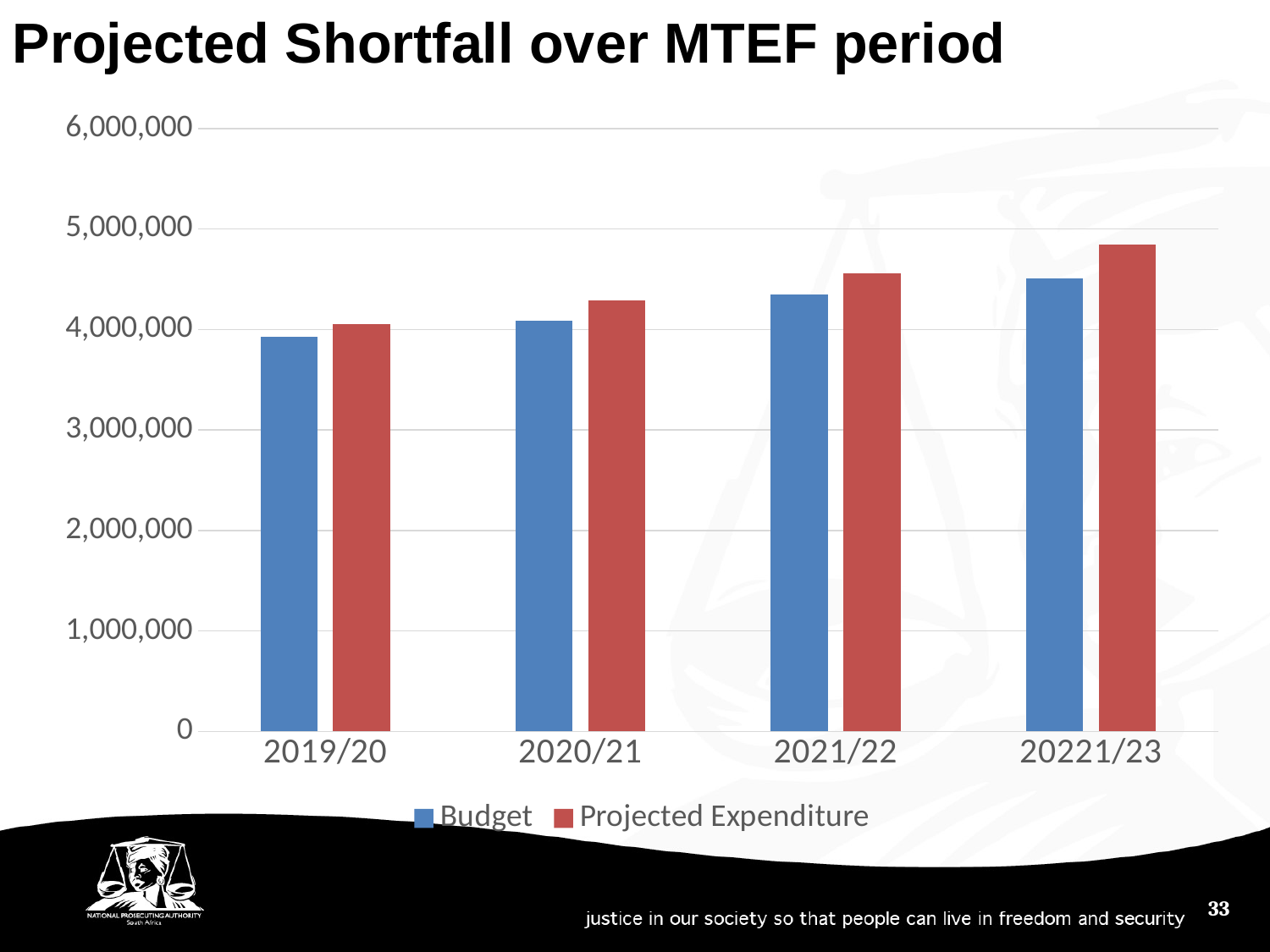
How many series does the legend list? 2 Is the Projected Expenditure for 2020/21 greater or less than 4,000,000? greater Do the Budget values rise or fall from 2019/20 to 20221/23? rise Is the Budget for 2021/22 greater or less than 4,000,000? greater Is the Budget for 2019/20 greater or less than 3,000,000? greater Which year has the highest Projected Expenditure? 20221/23 What colour are the Budget bars? blue How many financial years are shown on the x axis? 4 What kind of chart is shown on the slide? bar chart Which year has the lowest Budget? 2019/20 In 20221/23, which is larger, Budget or Projected Expenditure? Projected Expenditure